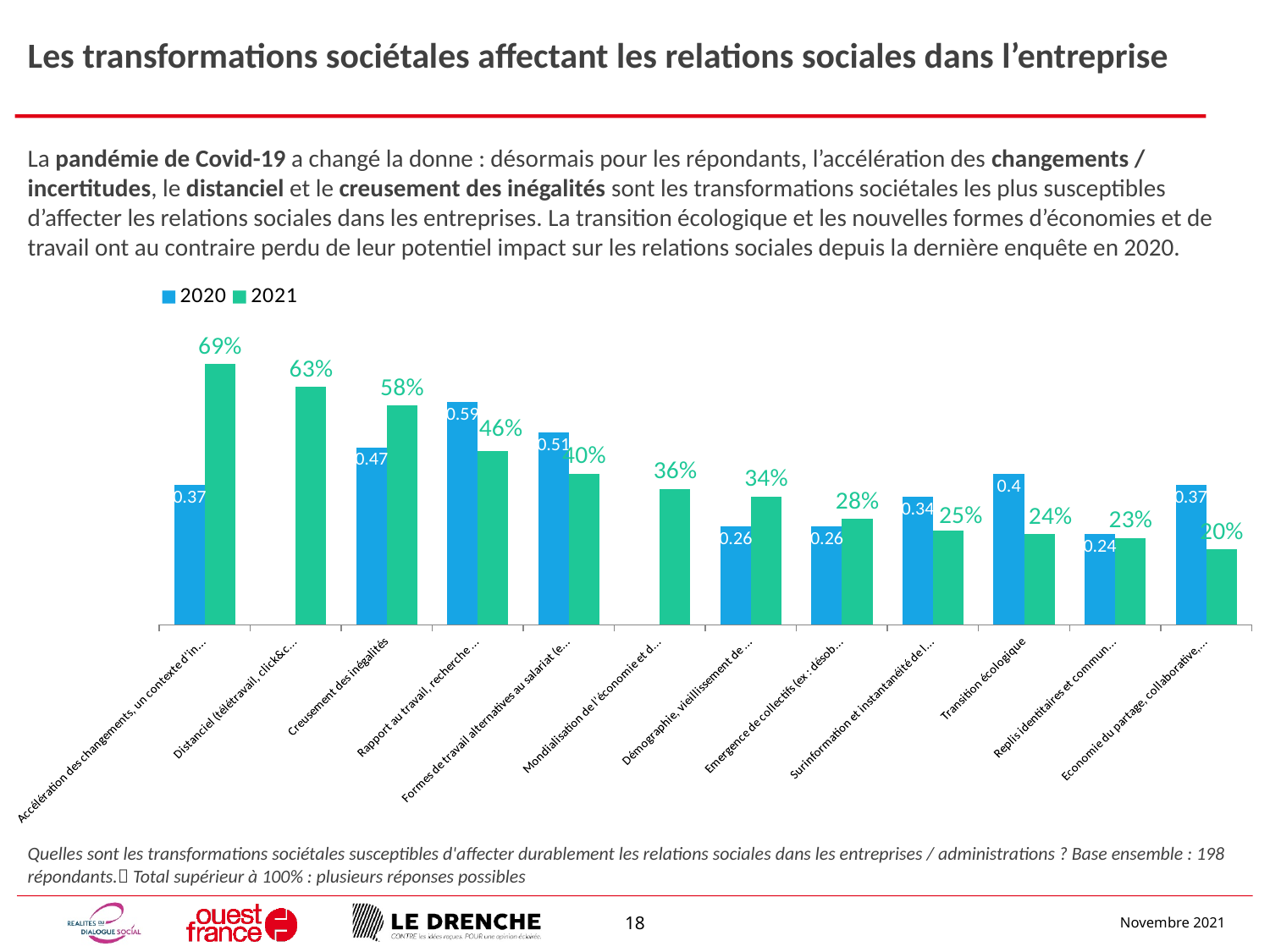
What is the 2020 value for "Transition écologique"? 0.4 Which category has the lowest 2021 value? Economie du partage, collaborative,... (20%) Which category has the highest 2021 value? Accélération des changements, un contexte d'in... (69%) Which years are listed in the chart legend? 2020 and 2021 How many series does the chart legend list? 2 What is the 2021 value for "Transition écologique"? 24% What is the 2020 value for "Creusement des inégalités"? 0.47 For "Transition écologique", is the 2020 bar or the 2021 bar larger? 2020 How many categories are shown on the x axis of the chart? 12 What is the 2021 value for "Creusement des inégalités"? 58% Do the 2021 values rise or fall from left to right across the categories? Fall What kind of chart is shown on the slide? Bar chart